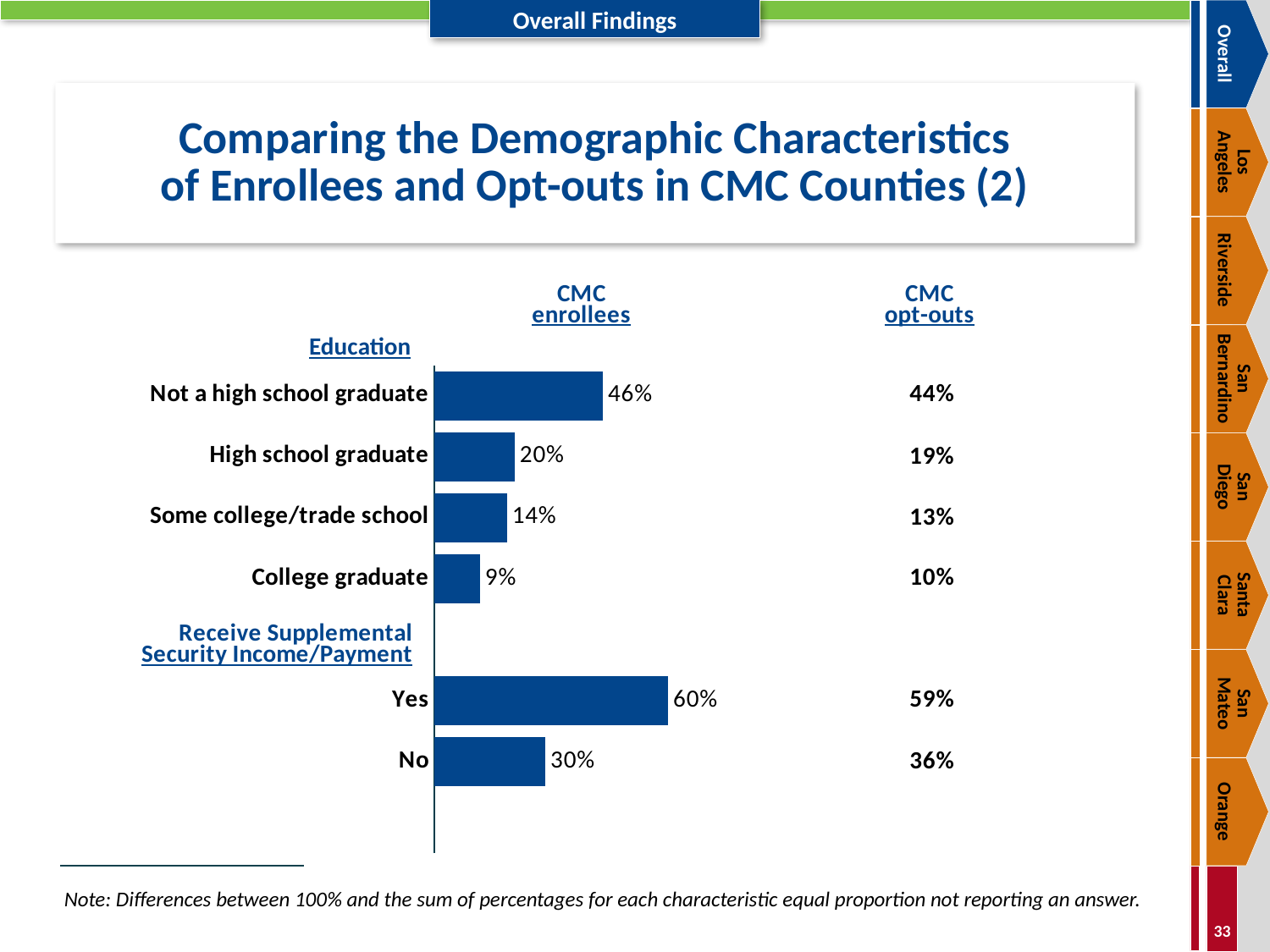
Among the Education categories, which has the highest percentage of CMC enrollees? Not a high school graduate What type of chart is used to show the CMC enrollees percentages? Bar chart What is the title of the slide's chart? Comparing the Demographic Characteristics of Enrollees and Opt-outs in CMC Counties (2) Among the Education categories, which has the lowest percentage of CMC enrollees? College graduate What is the difference between the CMC enrollees and CMC opt-outs percentages for 'No' under Receive Supplemental Security Income/Payment? 6% What percentage of CMC enrollees are not a high school graduate? 46% How many Education categories are shown in the chart? 4 Which is larger: the CMC enrollees percentage for 'Some college/trade school' or the CMC opt-outs percentage for 'Some college/trade school'? CMC enrollees What percentage of CMC opt-outs are college graduates? 10% What percentage of CMC opt-outs do not receive Supplemental Security Income/Payment (No)? 36% What percentage of CMC enrollees receive Supplemental Security Income/Payment (Yes)? 60% What is the difference between the CMC enrollees percentages for 'Not a high school graduate' and 'High school graduate'? 26%